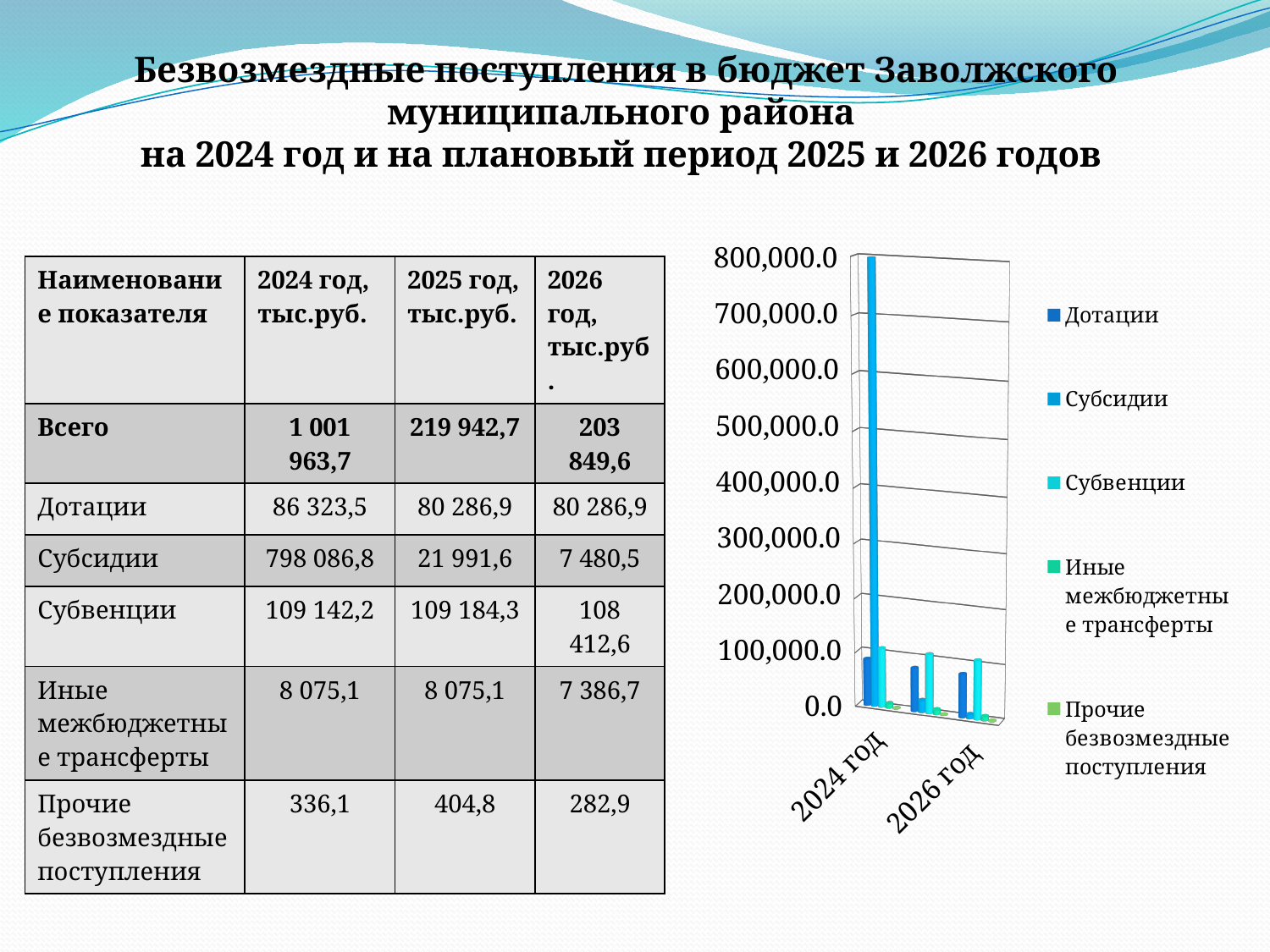
In 2024 год, which is larger: Дотации or Субвенции? Субвенции Is the value for Субсидии in 2024 год greater or less than 700,000.0? greater Which series has the tallest bar for 2024 год? Субсидии How many series does the chart legend list? 5 What is the total (Всего) of all безвозмездные поступления for 2024 год, тыс.руб.? 1 001 963,7 What is the value for Субвенции in 2026 год, тыс.руб.? 108 412,6 What is the difference between Субсидии in 2024 год and 2025 год, тыс.руб.? 776 095,2 Do the values for Субсидии rise or fall from 2024 год to 2026 год? fall What is the value for Субсидии in 2024 год, тыс.руб.? 798 086,8 What kind of chart is shown on the slide? bar chart What is the last series listed in the chart legend? Прочие безвозмездные поступления Is the value for Дотации in 2024 год greater or less than 100,000.0? less